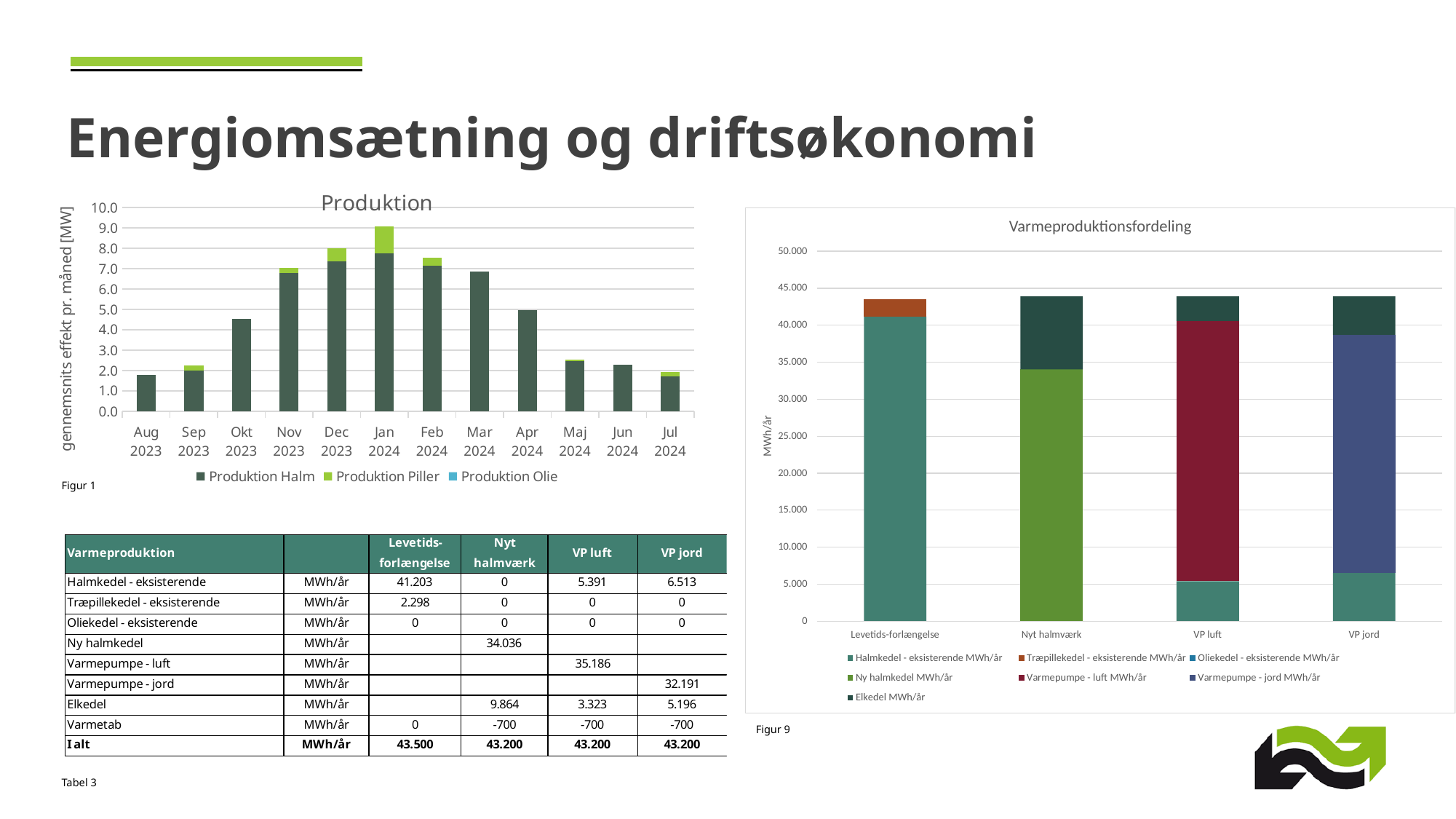
In the "Produktion" chart, which month has the highest total bar? Jan 2024 How many series does the legend of the "Produktion" chart list? 3 In the "Produktion" chart, is the value for Mar 2024 greater or less than 6.0? greater In the "Produktion" chart, is the value for Okt 2023 greater or less than 4.0? greater In the "Produktion" chart, which is larger, the bar for Dec 2023 or the bar for Mar 2024? Dec 2023 What is the y-axis label of the "Produktion" chart? gennemsnits effekt pr. måned [MW] What kind of chart is the "Produktion" chart? bar chart How many series does the legend of the "Varmeproduktionsfordeling" chart list? 7 In the "Produktion" chart, do the values rise or fall from Jan 2024 to Jul 2024? fall How many categories are shown on the x axis of the "Varmeproduktionsfordeling" chart? 4 In the "Varmeproduktionsfordeling" chart, is the total for Levetids-forlængelse greater or less than 45.000? less How many months are shown on the x axis of the "Produktion" chart? 12